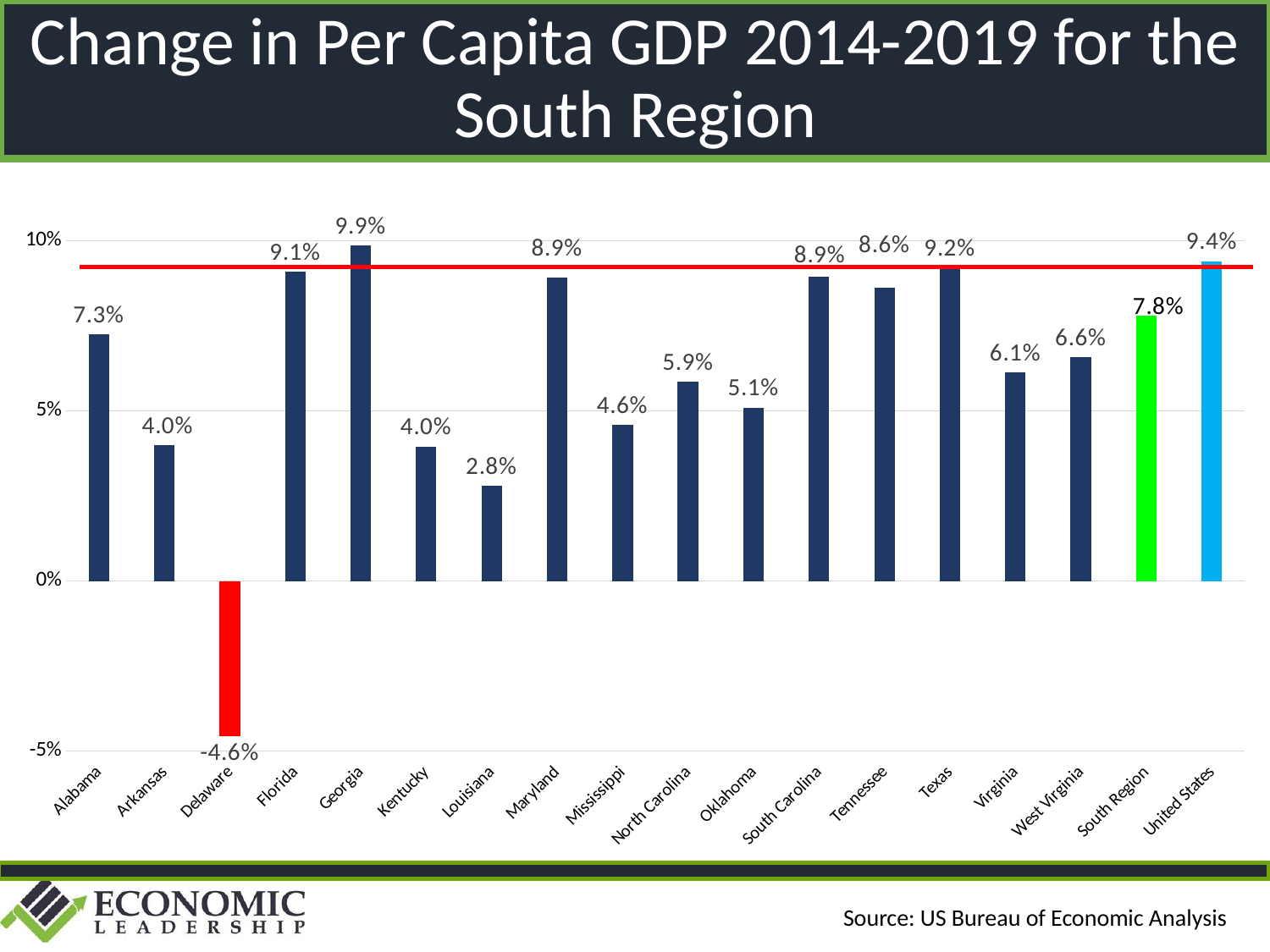
What is the value shown for the South Region bar? 7.8% How many bars are shown on the chart? 18 Which has a larger value, Florida or Tennessee? Florida What kind of chart is shown on the slide? Bar chart Which state has the highest change in per capita GDP? Georgia What is the change in per capita GDP for Georgia? 9.9% Which category has the lowest value on the chart? Delaware Is the value for Mississippi greater or less than 5%? less What is the difference between the values for Texas and Louisiana? 6.4% What is the value shown for the United States? 9.4% What is the value shown for Delaware? -4.6% What colour is the Delaware bar? Red